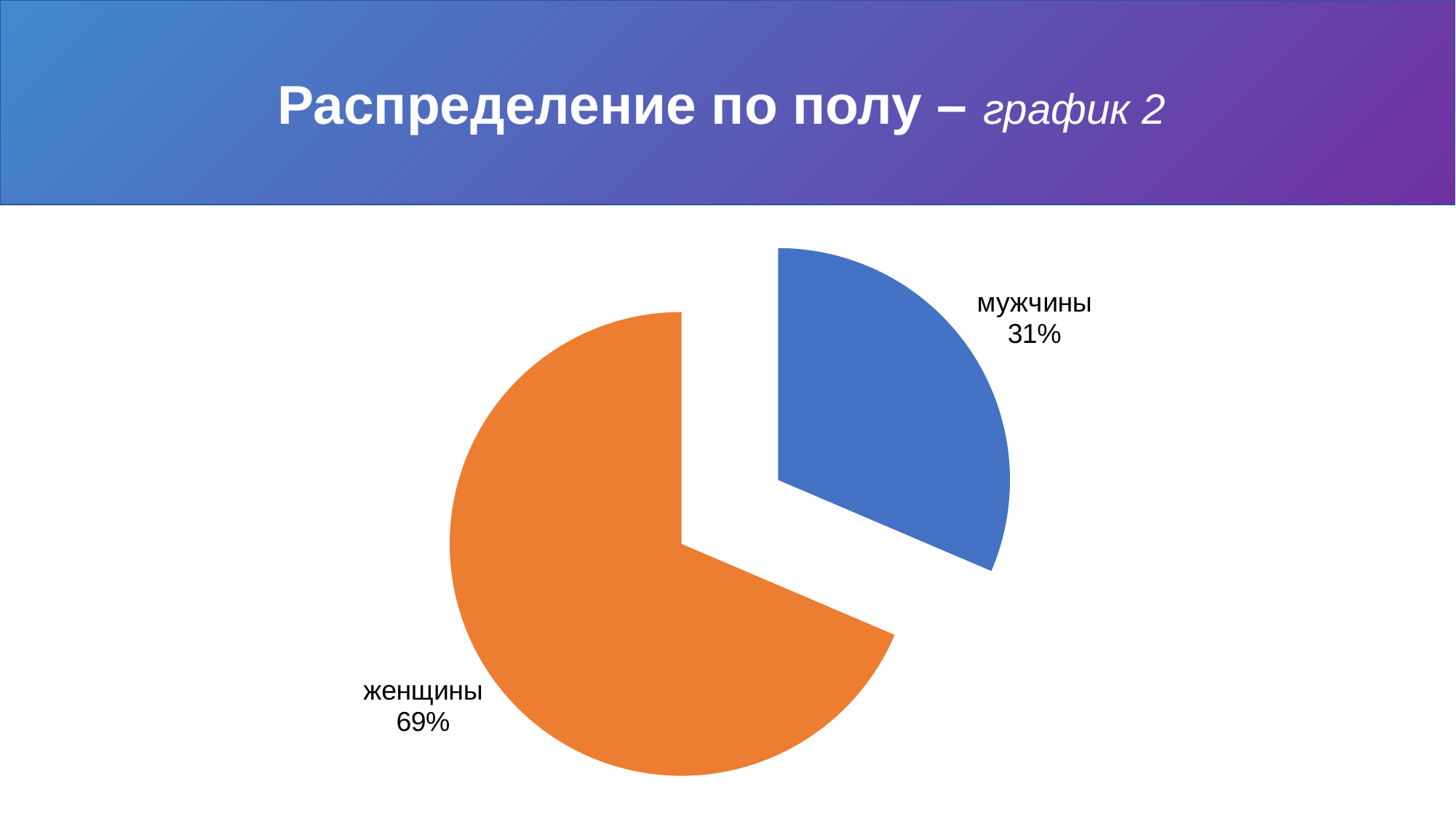
What colour is the slice for мужчины? blue What is the title of the slide? Распределение по полу – график 2 What share of the pie does мужчины have? 31% What share of the pie does женщины have? 69% Which is larger, the share for женщины or the share for мужчины? женщины What kind of chart is shown on the slide? pie chart Which category has the largest slice of the pie? женщины Which category has the smallest slice of the pie? мужчины How many slices does the pie chart have? 2 What is the difference in percentage points between женщины and мужчины? 38